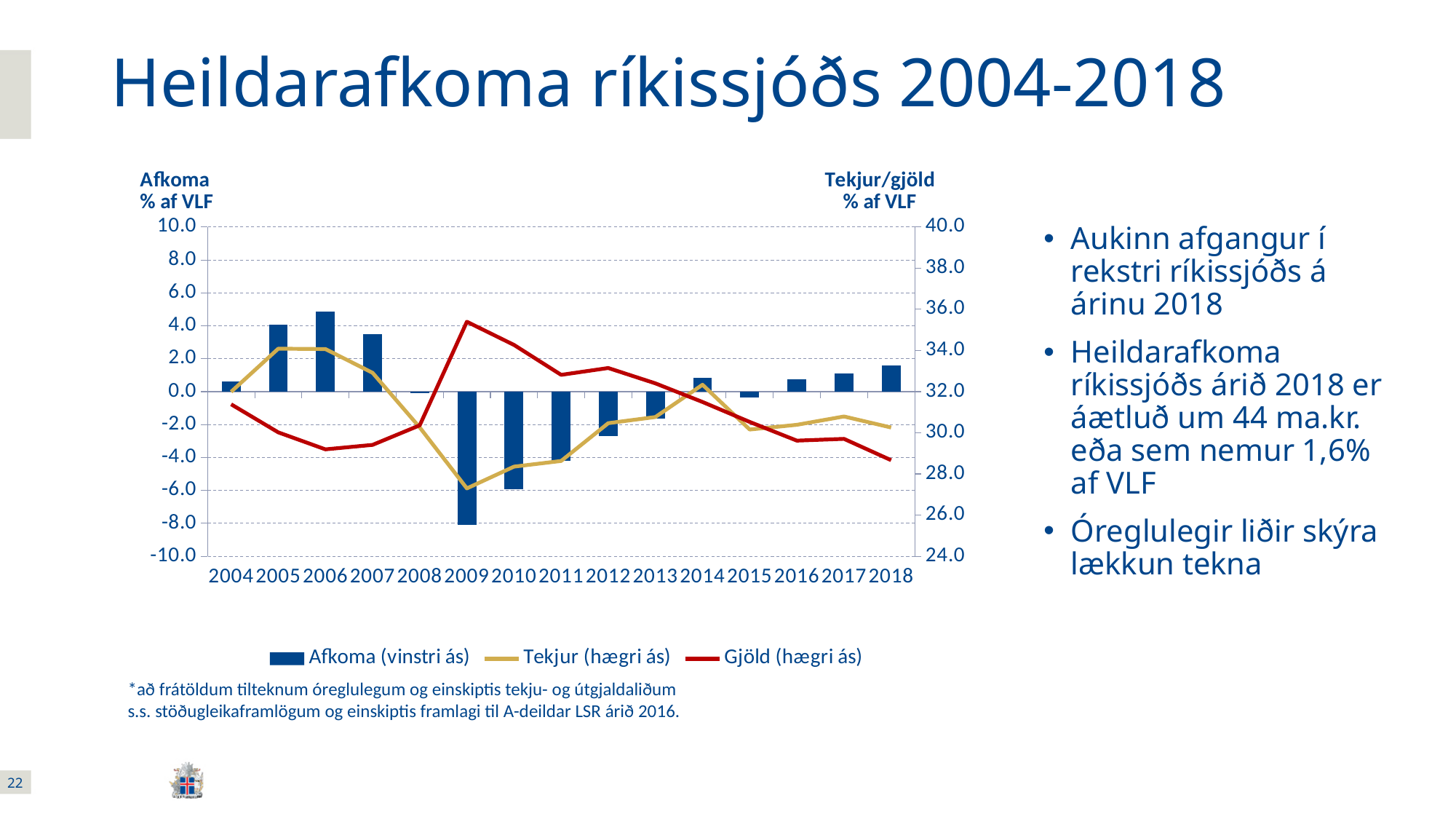
Which series is plotted on the left axis according to the legend? Afkoma (vinstri ás) Is the Afkoma value for 2006 greater or less than 4.0? greater In 2009, which is higher, Tekjur or Gjöld? Gjöld Is the Gjöld value for 2018 greater or less than 30.0? less Does the Gjöld line rise or fall from 2014 to 2018? Fall How many series does the chart legend list? 3 How many years are shown on the x axis of the chart? 15 In which year is the Afkoma bar lowest? 2009 Is the Afkoma value for 2009 greater or less than -6.0? less What kind of chart is shown on the slide? A combined bar and line chart In which year is the Afkoma bar highest? 2006